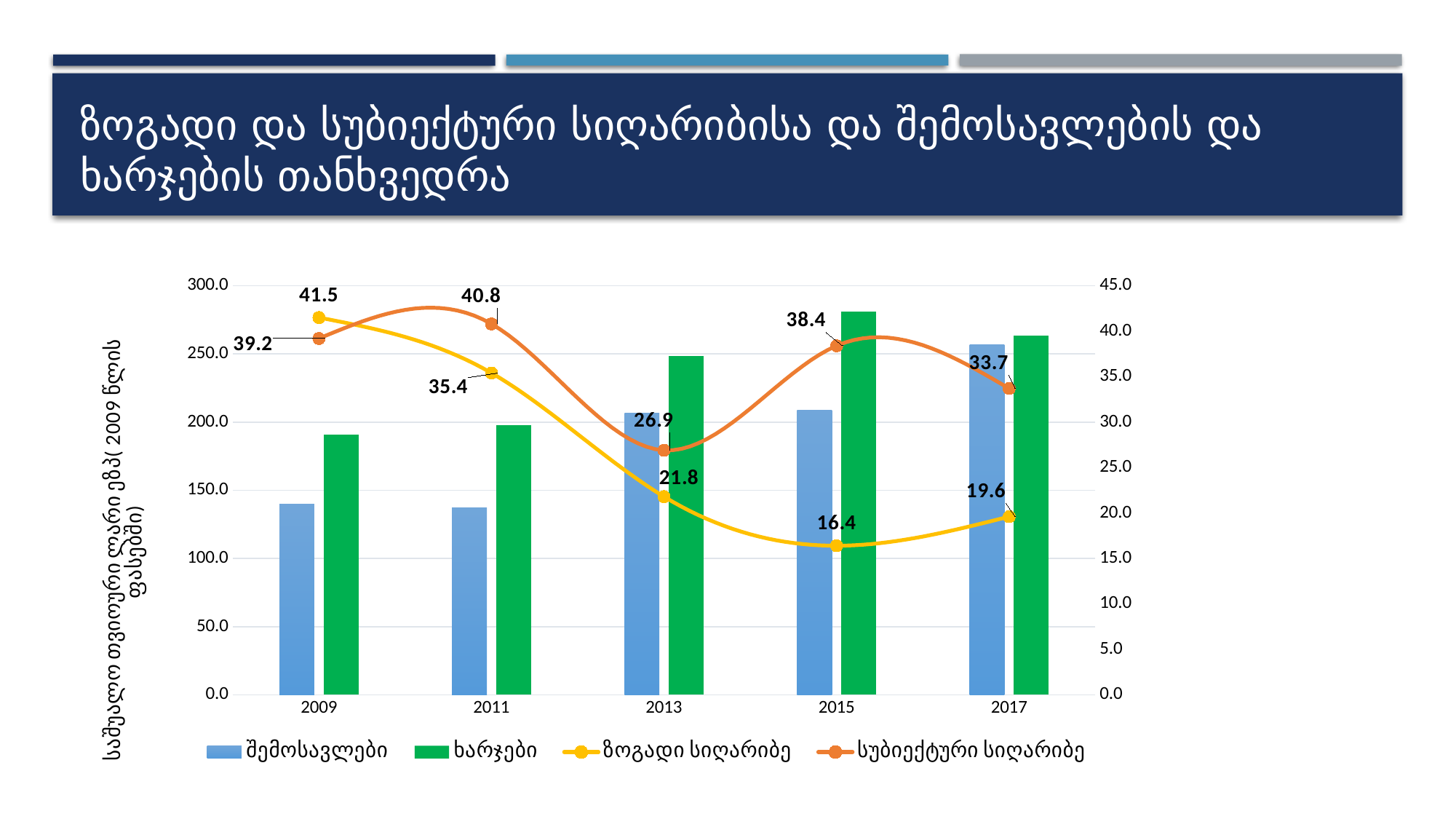
Is the value of the ხარჯები bar for 2015 greater or less than 250.0? greater In which year is სუბიექტური სიღარიბე highest? 2011 What is the value of ზოგადი სიღარიბე in 2009? 41.5 What is the difference between ზოგადი სიღარიბე in 2009 and in 2011? 6.1 What is the value of სუბიექტური სიღარიბე in 2015? 38.4 In which year is ზოგადი სიღარიბე lowest? 2015 How many series does the legend list? 4 Does ზოგადი სიღარიბე rise or fall from 2009 to 2015? fall What is the value of ზოგადი სიღარიბე in 2017? 19.6 Is the value of the შემოსავლები bar for 2009 greater or less than 150.0? less How many years are shown on the x axis? 5 Which is larger in 2013: ზოგადი სიღარიბე or სუბიექტური სიღარიბე? სუბიექტური სიღარიბე